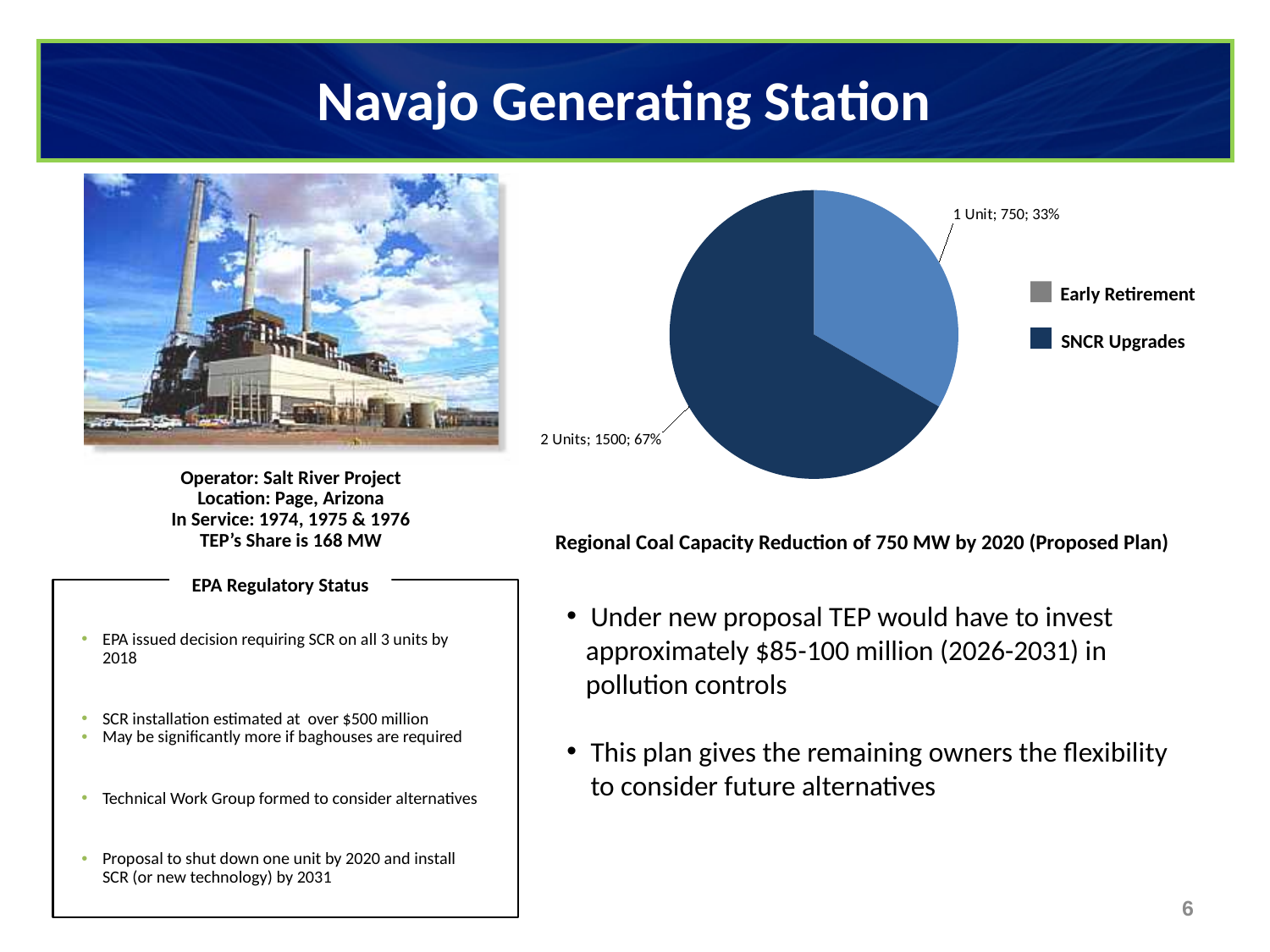
What share of the pie does the '1 Unit' slice represent? 33% Which is larger in the pie chart, the '1 Unit' slice or the '2 Units' slice? 2 Units What share of the pie does the '2 Units' slice represent? 67% How many entries does the pie chart's legend list? 2 Which slice of the pie chart is the smallest? 1 Unit What kind of chart is shown on the slide? Pie chart Which slice of the pie chart is the largest? 2 Units What are the two entries listed in the pie chart's legend? Early Retirement and SNCR Upgrades What value is labelled on the '1 Unit' slice of the pie chart? 750 What is the difference between the '2 Units' value and the '1 Unit' value in the pie chart? 750 How many slices does the pie chart have? 2 What value is labelled on the '2 Units' slice of the pie chart? 1500